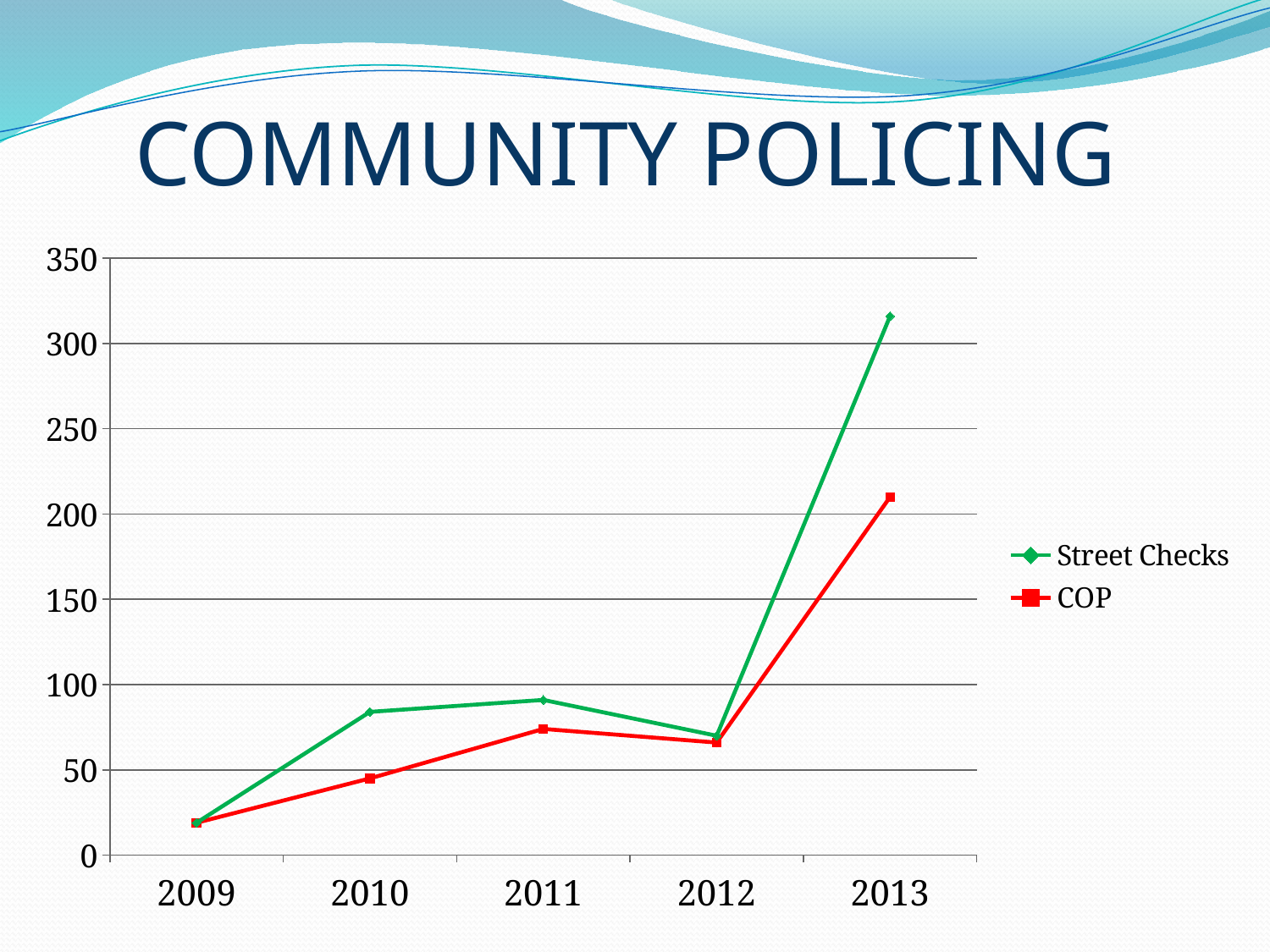
In 2010, which series has the larger value, Street Checks or COP? Street Checks Is the Street Checks value for 2011 greater or less than 100? less In which year is the Street Checks value highest? 2013 How many years are plotted along the x axis? 5 What kind of chart is shown on the slide? line chart In which year is the COP value highest? 2013 In which year is the COP value lowest? 2009 How many series does the legend list? 2 Is the Street Checks value for 2013 greater or less than 300? greater Do the Street Checks values rise or fall from 2012 to 2013? rise Is the COP value for 2013 greater or less than 200? greater